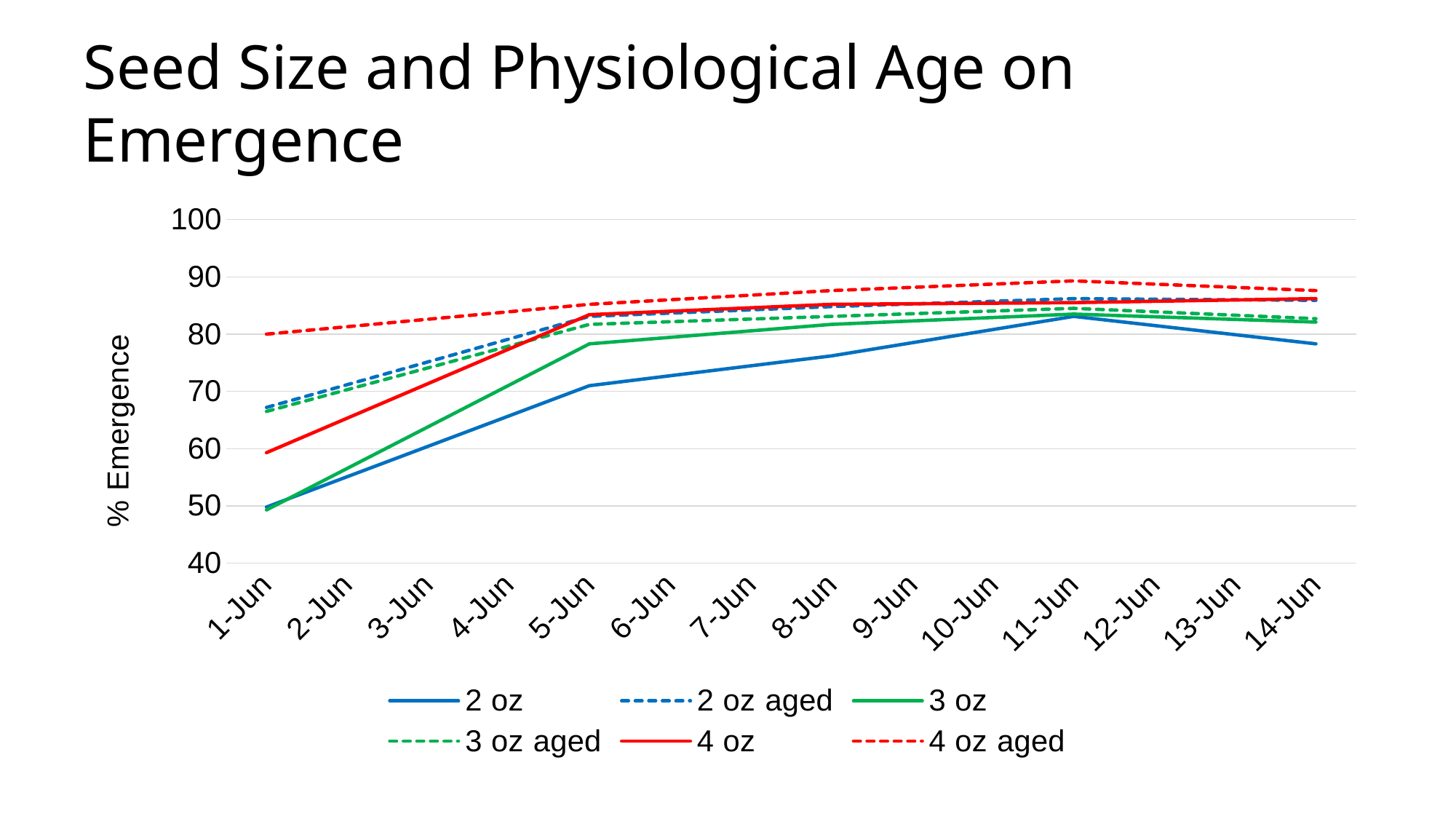
Which series has the highest value on 1-Jun? 4 oz aged What kind of chart is shown on the slide? line chart How many dates are shown along the x axis? 14 Is the value for 4 oz aged on 11-Jun greater or less than 80? greater On 1-Jun, which is larger: the value for 4 oz or the value for 3 oz? 4 oz Does the 2 oz series rise or fall from 1-Jun to 5-Jun? rise Which series has the lowest value on 14-Jun? 2 oz What is the title of the slide containing the chart? Seed Size and Physiological Age on Emergence What is the label on the vertical axis? % Emergence Is the value for 2 oz on 1-Jun greater or less than 60? less How many series does the legend list? 6 Is the value for 3 oz on 5-Jun greater or less than 70? greater